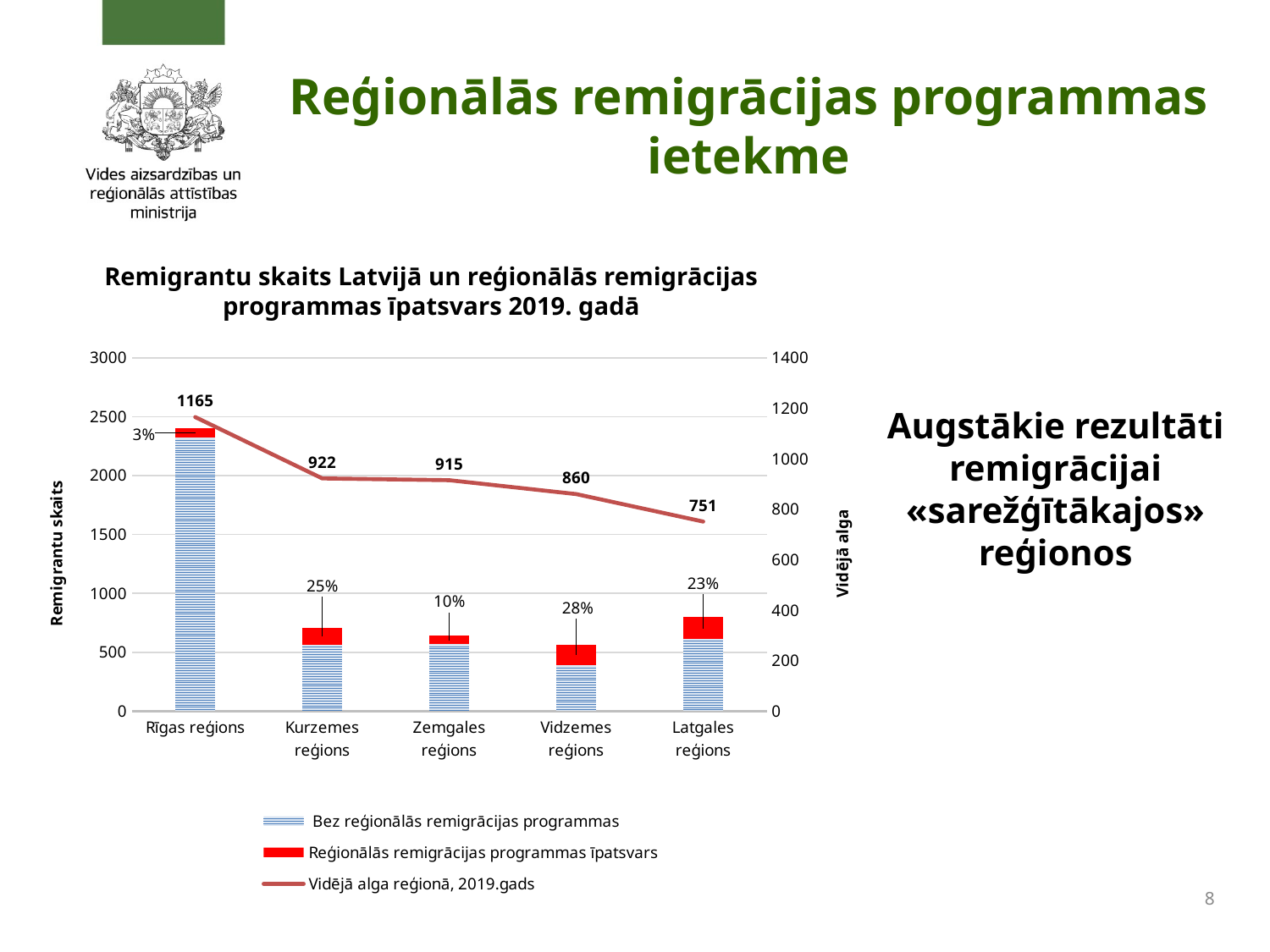
How many series does the legend list? 3 Which region has the highest average wage on the line? Rīgas reģions Which region has the higher average wage, Kurzemes reģions or Zemgales reģions? Kurzemes reģions Which region has the lowest average wage on the line? Latgales reģions What percentage share of the regional remigration programme is shown for Vidzemes reģions? 28% How many regions are shown on the x axis? 5 What is the difference between the average wage in Rīgas reģions and Latgales reģions? 414 What is the average wage value shown for Latgales reģions? 751 What percentage share of the regional remigration programme is shown for Kurzemes reģions? 25% Is the total remigrant count bar for Rīgas reģions greater or less than 2000? greater What is the average wage (Vidējā alga) shown for Rīgas reģions? 1165 Does the average wage line rise or fall from Rīgas reģions to Latgales reģions? fall